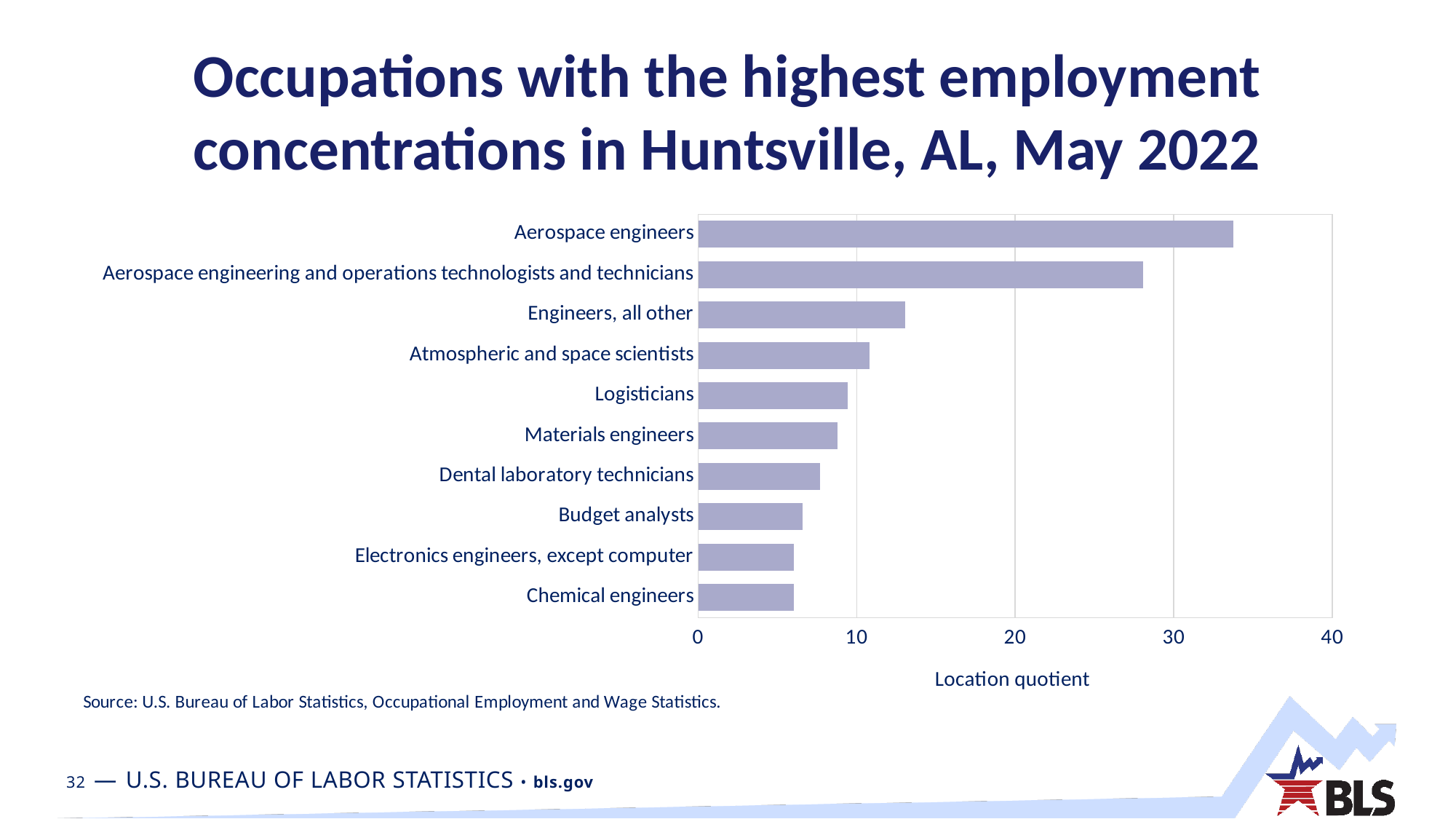
Is the location quotient for Aerospace engineering and operations technologists and technicians greater or less than 30? less Is the location quotient for Engineers, all other greater or less than 10? greater What is the title of the chart on the slide? Occupations with the highest employment concentrations in Huntsville, AL, May 2022 Which has a larger location quotient, Atmospheric and space scientists or Dental laboratory technicians? Atmospheric and space scientists Which has a larger location quotient, Engineers, all other or Materials engineers? Engineers, all other Is the location quotient for Chemical engineers greater or less than 10? less What kind of chart is shown on the slide? bar chart Which occupation has the highest location quotient? Aerospace engineers What is the label on the horizontal axis of the chart? Location quotient How many occupations are plotted in the chart? 10